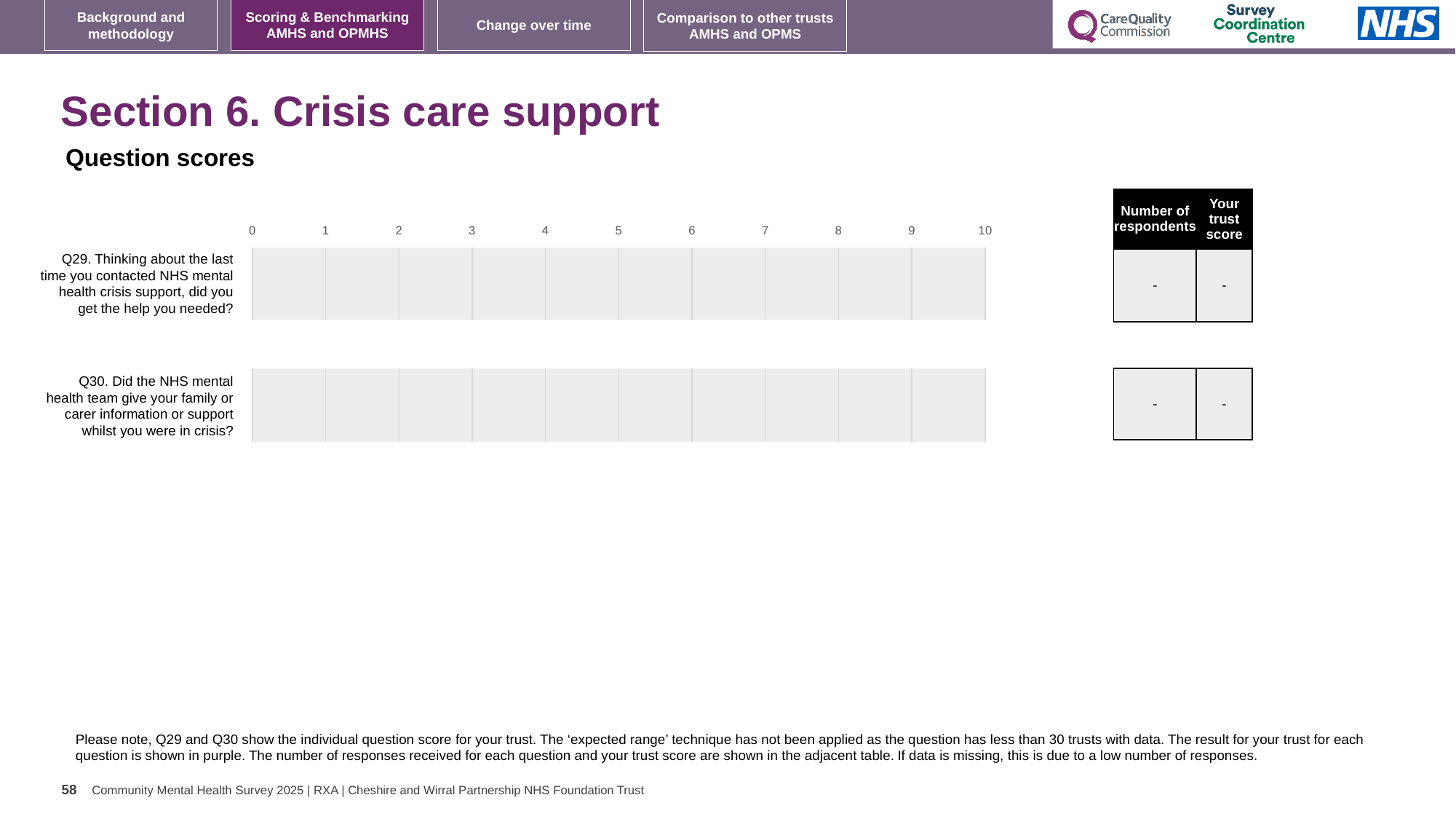
What is shown as the trust score for Q30 in the table next to the chart? - How many questions are plotted on the chart? 2 What is the highest value shown on the chart's axis? 10 What kind of chart is shown on the slide? bar chart What is shown as the trust score for Q29 in the table next to the chart? - What is the lowest value shown on the chart's axis? 0 What is shown as the number of respondents for Q30 in the table next to the chart? - What is shown as the number of respondents for Q29 in the table next to the chart? -